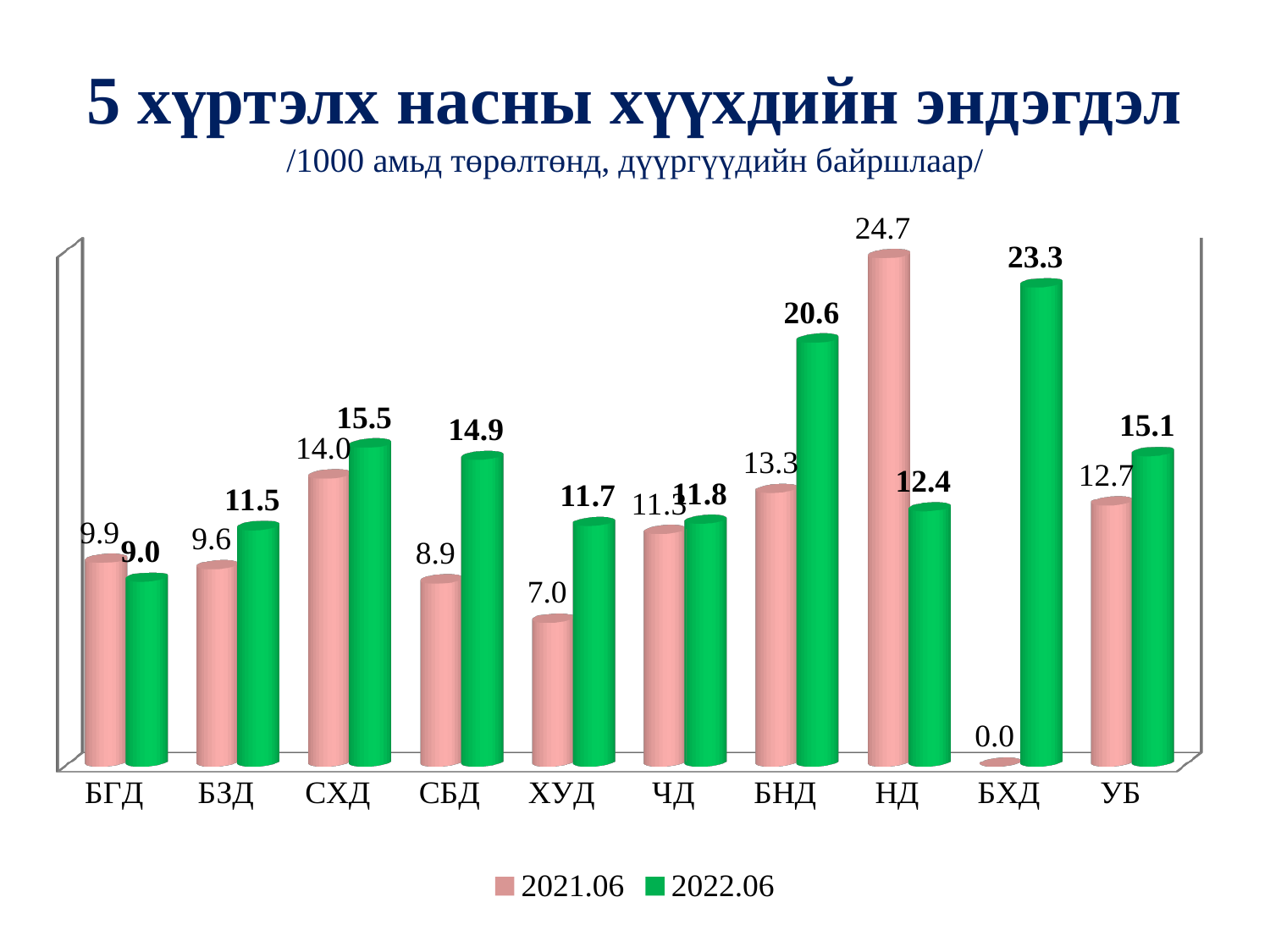
Which category has the lowest value in the 2022.06 series? БГД What is the value for НД in the 2021.06 series? 24.7 What kind of chart is shown on the slide? Bar chart How many series does the legend list? 2 For НД, which series has the larger value, 2021.06 or 2022.06? 2021.06 What is the difference between the 2022.06 and 2021.06 values for БНД? 7.3 What is the value for ХУД in the 2021.06 series? 7.0 Which series is shown in green in the legend? 2022.06 Which category has the highest value in the 2021.06 series? НД What is the value for СБД in the 2022.06 series? 14.9 What is the value for БХД in the 2022.06 series? 23.3 How many categories are shown on the x axis? 10